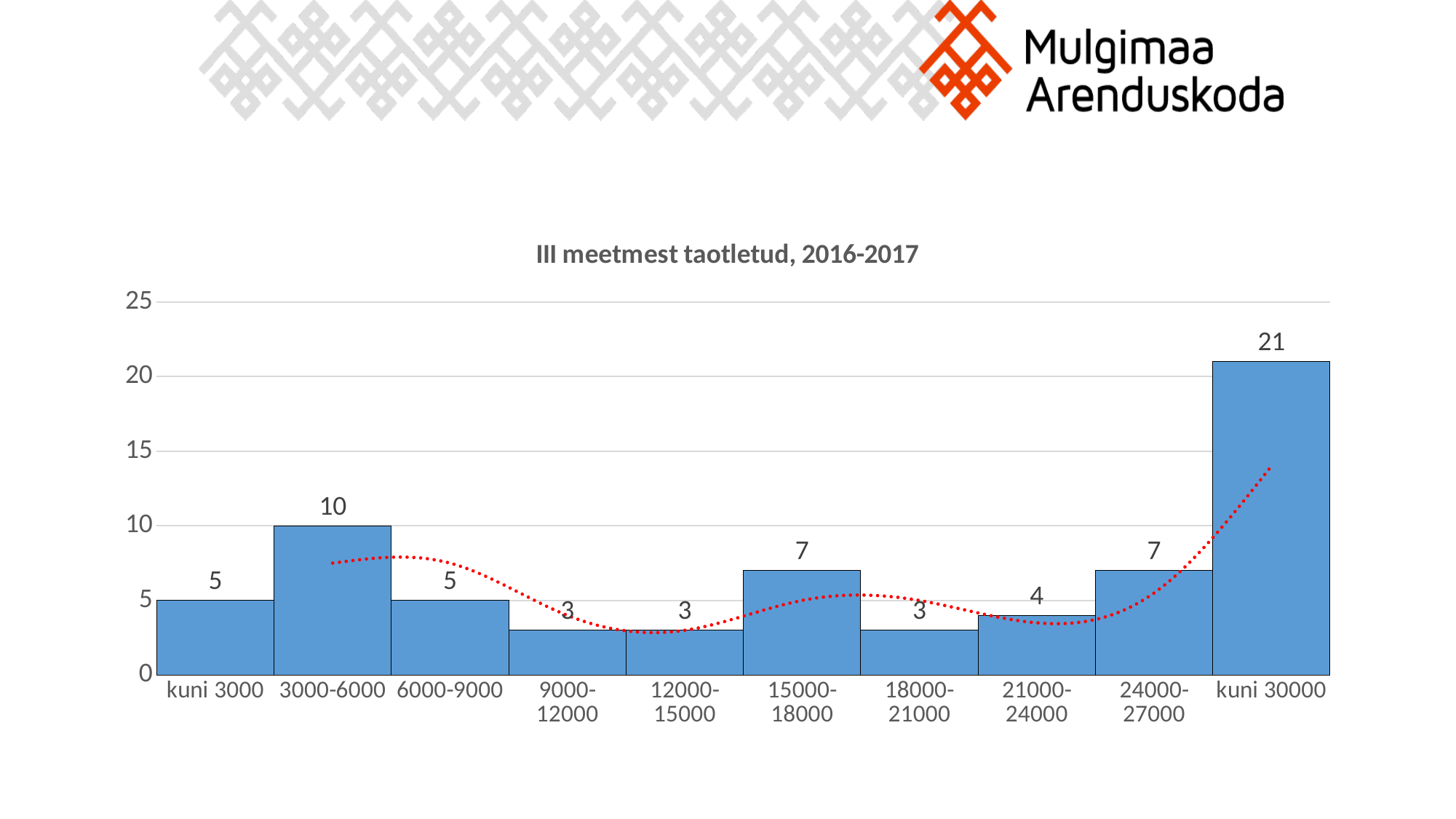
What is the value for the kuni 30000 category? 21 Which is larger, the value for 15000-18000 or the value for 18000-21000? 15000-18000 What is the value for the 24000-27000 category? 7 What is the value for the 3000-6000 category? 10 What kind of chart is shown on the slide? bar chart Which category has the highest value? kuni 30000 What is the difference between the values for 15000-18000 and 12000-15000? 4 What is the difference between the values for kuni 30000 and 3000-6000? 11 What is the value for the 21000-24000 category? 4 How many categories are shown on the x axis? 10 What is the title of the chart? III meetmest taotletud, 2016-2017 Is the value for kuni 30000 greater or less than 20? greater